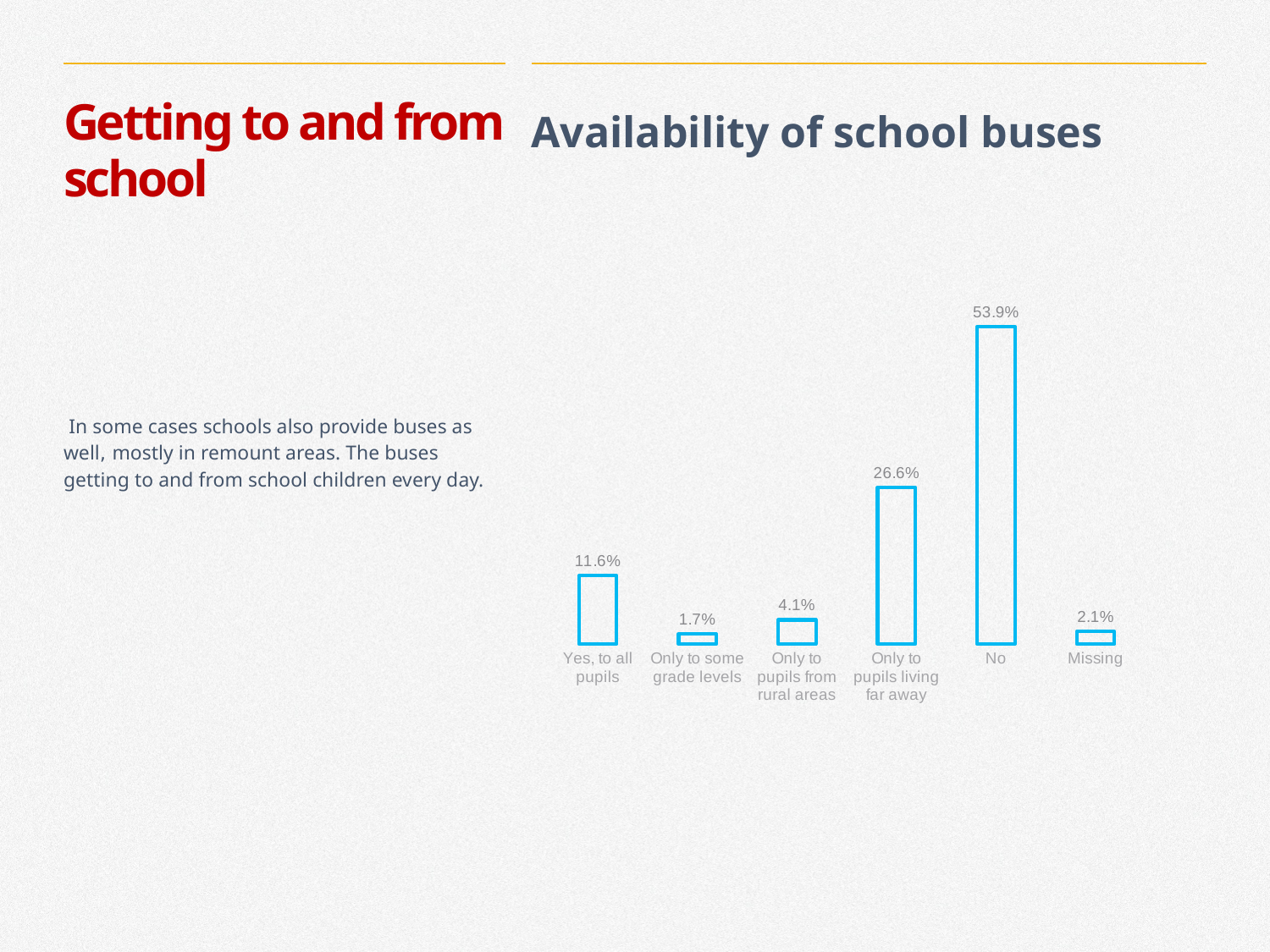
How many categories are shown in the chart? 6 What is the value for "Yes, to all pupils"? 11.6% What is the title of the chart? Availability of school buses Which category has the lowest value? Only to some grade levels What is the value for "Missing"? 2.1% What kind of chart is shown on the slide? Bar chart What is the difference between the values for "Yes, to all pupils" and "Only to pupils from rural areas"? 7.5% Which category has the highest value? No What is the value for "No" in the Availability of school buses chart? 53.9% What is the difference between the values for "No" and "Only to pupils living far away"? 27.3% What is the value for "Only to pupils living far away"? 26.6% Which is larger, the value for "Only to pupils from rural areas" or the value for "Missing"? Only to pupils from rural areas